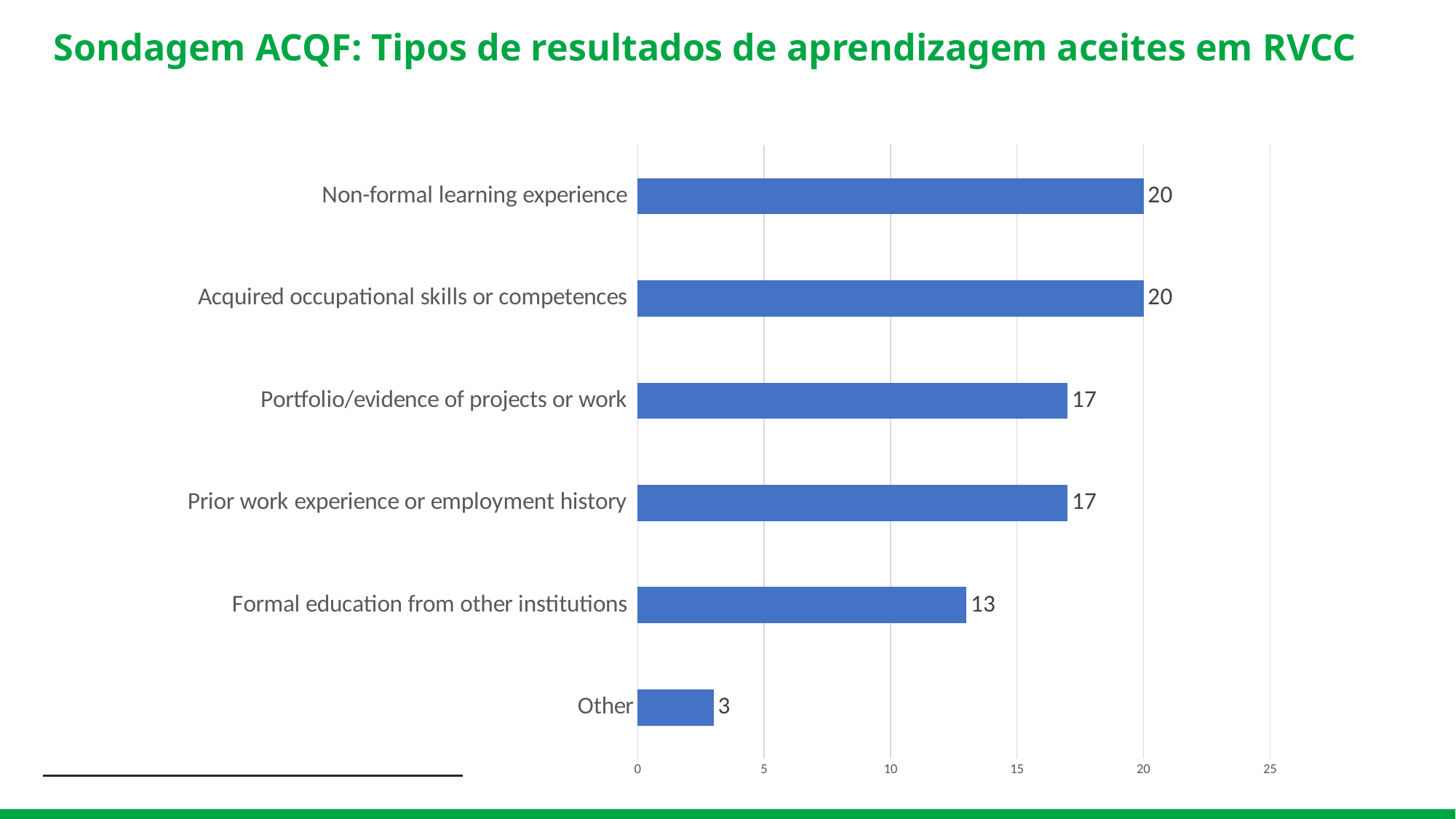
Which is larger, the value for Portfolio/evidence of projects or work or the value for Formal education from other institutions? Portfolio/evidence of projects or work What is the value for Non-formal learning experience? 20 What is the value for Formal education from other institutions? 13 What is the difference between the values for Prior work experience or employment history and Other? 14 What is the value for Other? 3 What is the title of the slide? Sondagem ACQF: Tipos de resultados de aprendizagem aceites em RVCC Is the value for Formal education from other institutions greater or less than 15? less How many categories are shown in the chart? 6 What is the value for Portfolio/evidence of projects or work? 17 What kind of chart is shown on the slide? bar chart What is the difference between the values for Acquired occupational skills or competences and Formal education from other institutions? 7 Which category has the lowest value? Other